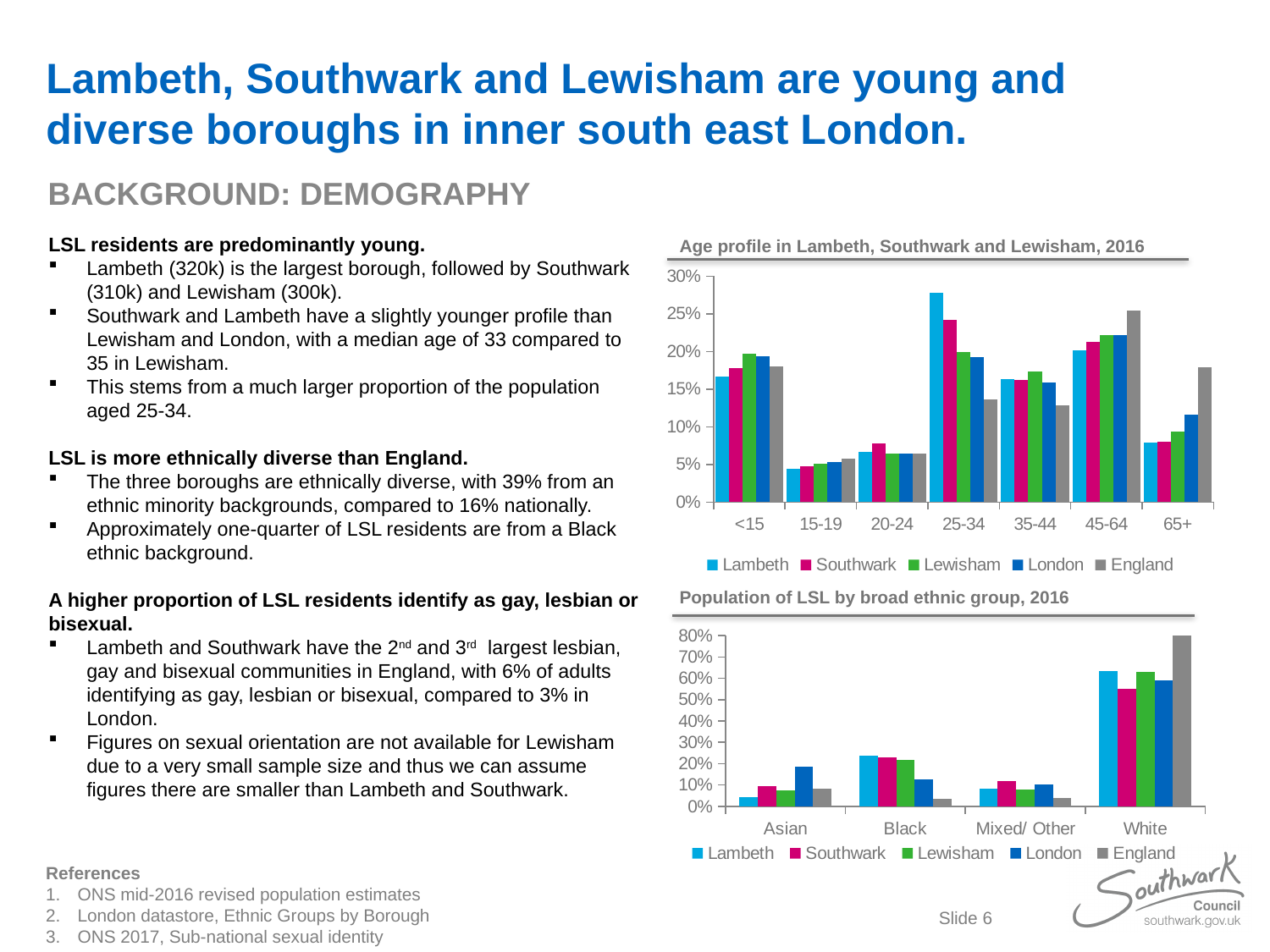
How many age groups are shown on the x axis of the 'Age profile in Lambeth, Southwark and Lewisham, 2016' chart? 7 In the 'Population of LSL by broad ethnic group, 2016' chart, which is larger for Asian: London or Lambeth? London In the 'Age profile in Lambeth, Southwark and Lewisham, 2016' chart, which age group has the lowest value for Lambeth? 15-19 In the 'Population of LSL by broad ethnic group, 2016' chart, is the England value for White greater or less than 70%? greater In the 'Age profile in Lambeth, Southwark and Lewisham, 2016' chart, is the Lambeth value for 25-34 greater or less than 25%? greater How many series does the legend of the 'Age profile in Lambeth, Southwark and Lewisham, 2016' chart list? 5 What kind of chart is the 'Age profile in Lambeth, Southwark and Lewisham, 2016' chart? bar chart In the 'Age profile in Lambeth, Southwark and Lewisham, 2016' chart, is the England value for 65+ greater or less than 15%? greater How many ethnic groups are shown on the x axis of the 'Population of LSL by broad ethnic group, 2016' chart? 4 In the 'Age profile in Lambeth, Southwark and Lewisham, 2016' chart, which is larger for the 65+ group: England or Lambeth? England In the 'Population of LSL by broad ethnic group, 2016' chart, which series has the highest value for White? England In the 'Age profile in Lambeth, Southwark and Lewisham, 2016' chart, which age group has the highest value for Lambeth? 25-34